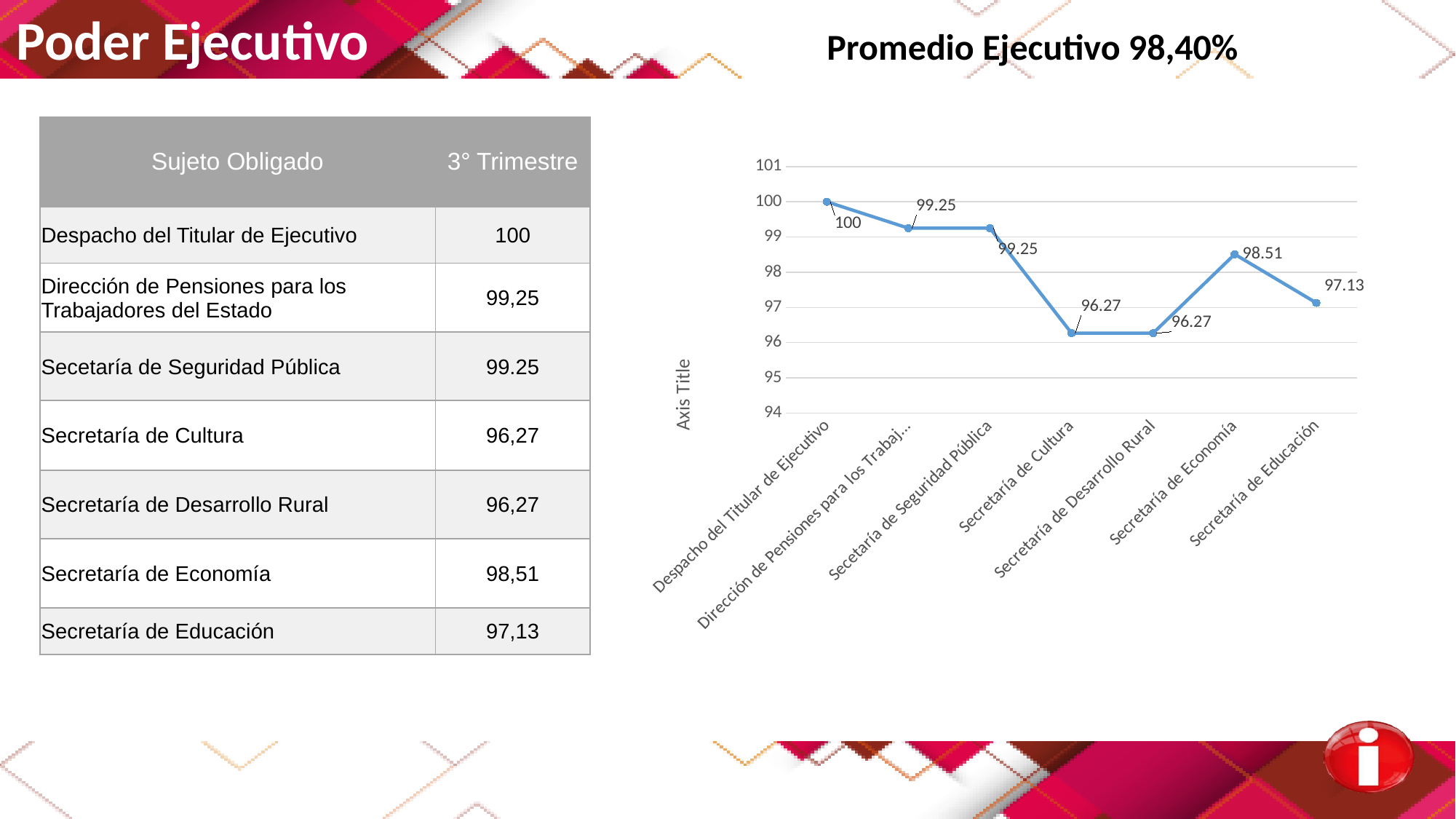
How many categories are plotted along the x axis of the chart? 7 What is the value plotted for Secretaría de Cultura? 96.27 What is the value plotted for Secretaría de Educación? 97.13 What is the difference between the values for Despacho del Titular de Ejecutivo and Secretaría de Educación? 2.87 What is the value plotted for Secretaría de Economía? 98.51 Is the value for Secretaría de Educación greater or less than 98? less What is the value plotted for Despacho del Titular de Ejecutivo? 100 Which category has the highest value in the chart? Despacho del Titular de Ejecutivo What type of chart is shown on the slide? line chart Does the line rise or fall between Secretaría de Desarrollo Rural and Secretaría de Economía? rise What is the lowest value plotted in the chart? 96.27 Which has a larger value, Secretaría de Economía or Secretaría de Desarrollo Rural? Secretaría de Economía